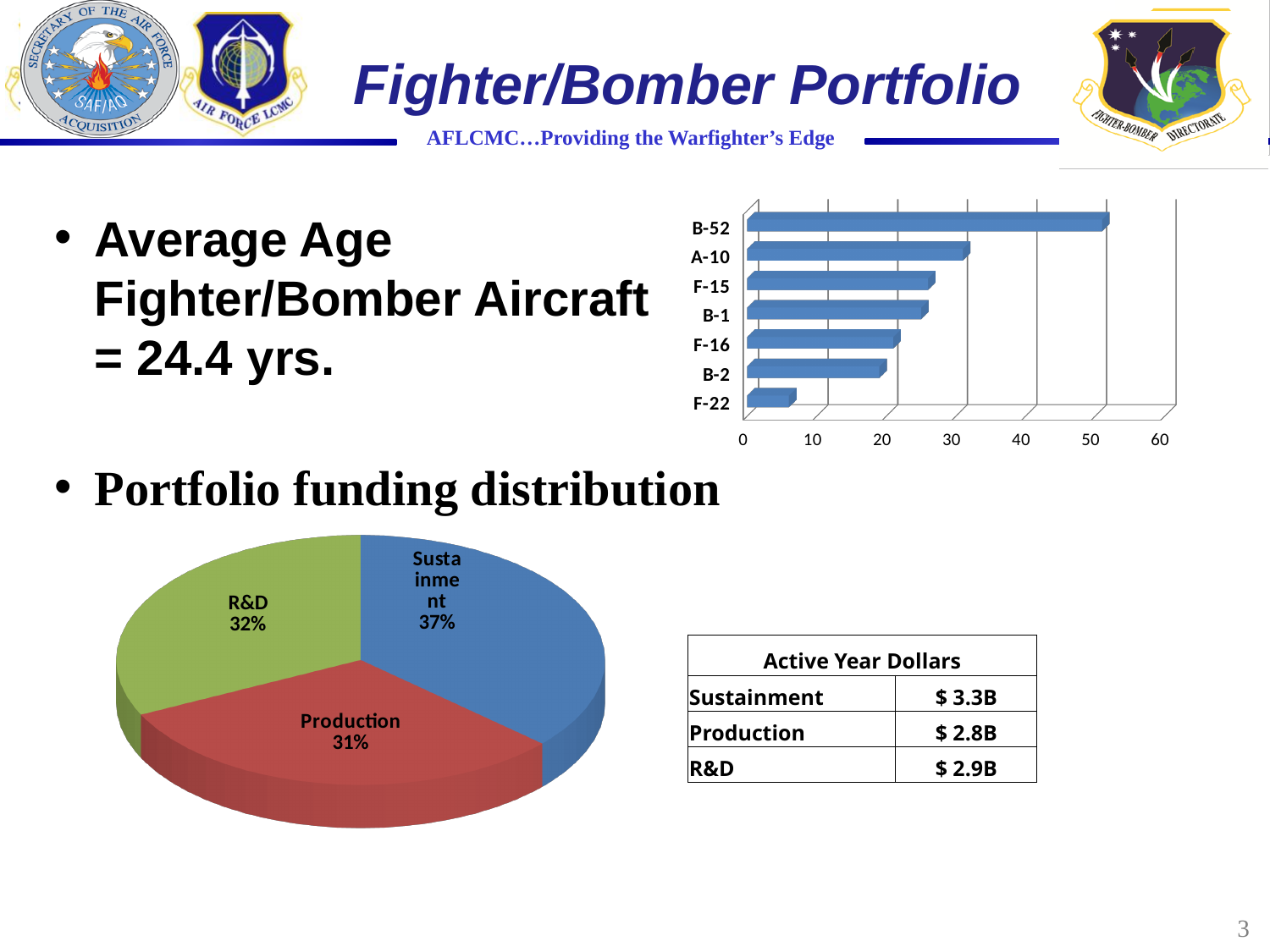
In the upper-right bar chart, how many aircraft types are listed? 7 In the portfolio funding distribution pie chart, how many slices are there? 3 In the portfolio funding distribution pie chart, which category has the largest share? Sustainment In the upper-right bar chart, which has the larger value, A-10 or F-16? A-10 What kind of chart is the portfolio funding distribution chart at the bottom left? pie chart In the portfolio funding distribution pie chart, what share does Sustainment have? 37% In the upper-right bar chart, which aircraft has the lowest value? F-22 What kind of chart is the chart in the upper right showing aircraft ages? bar chart In the portfolio funding distribution pie chart, what share does Production have? 31% In the upper-right bar chart, is the value for F-22 greater or less than 10? less In the upper-right bar chart, is the value for B-52 greater or less than 40? greater In the upper-right bar chart, which aircraft has the highest value? B-52